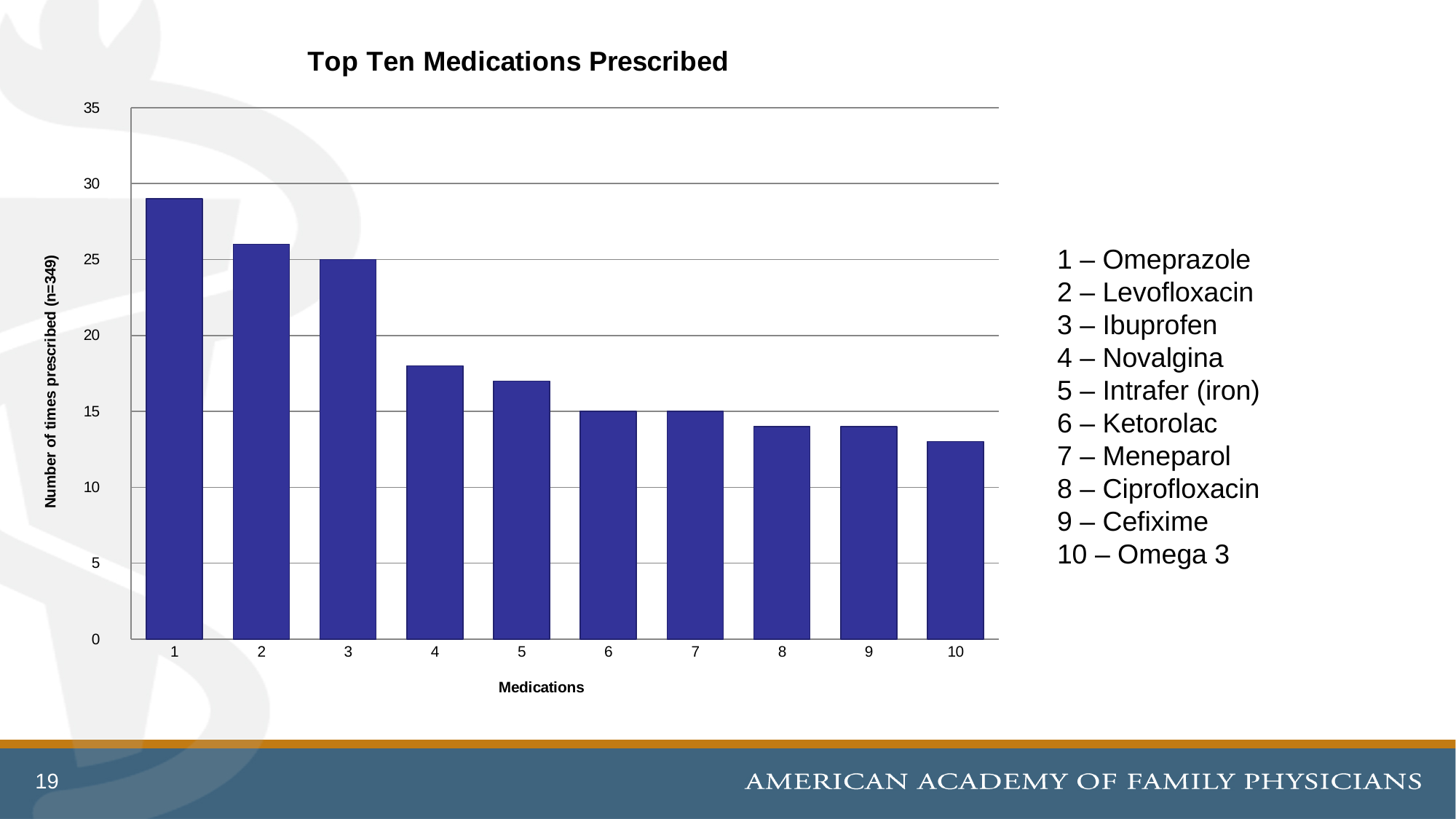
Which medication number has the lowest number of times prescribed? 10 How many medications are plotted on the x axis? 10 Is the value for medication 4 greater or less than 20? less How many times was medication 6 (Ketorolac) prescribed? 15 Do the values rise or fall from medication 1 to medication 10? fall What is the title of the chart? Top Ten Medications Prescribed Is the value for medication 10 greater or less than 10? greater What kind of chart is shown on the slide? bar chart Is the value for medication 1 greater or less than 25? greater Which was prescribed more times, medication 2 or medication 5? medication 2 Which medication number has the highest number of times prescribed? 1 How many times was medication 3 (Ibuprofen) prescribed? 25